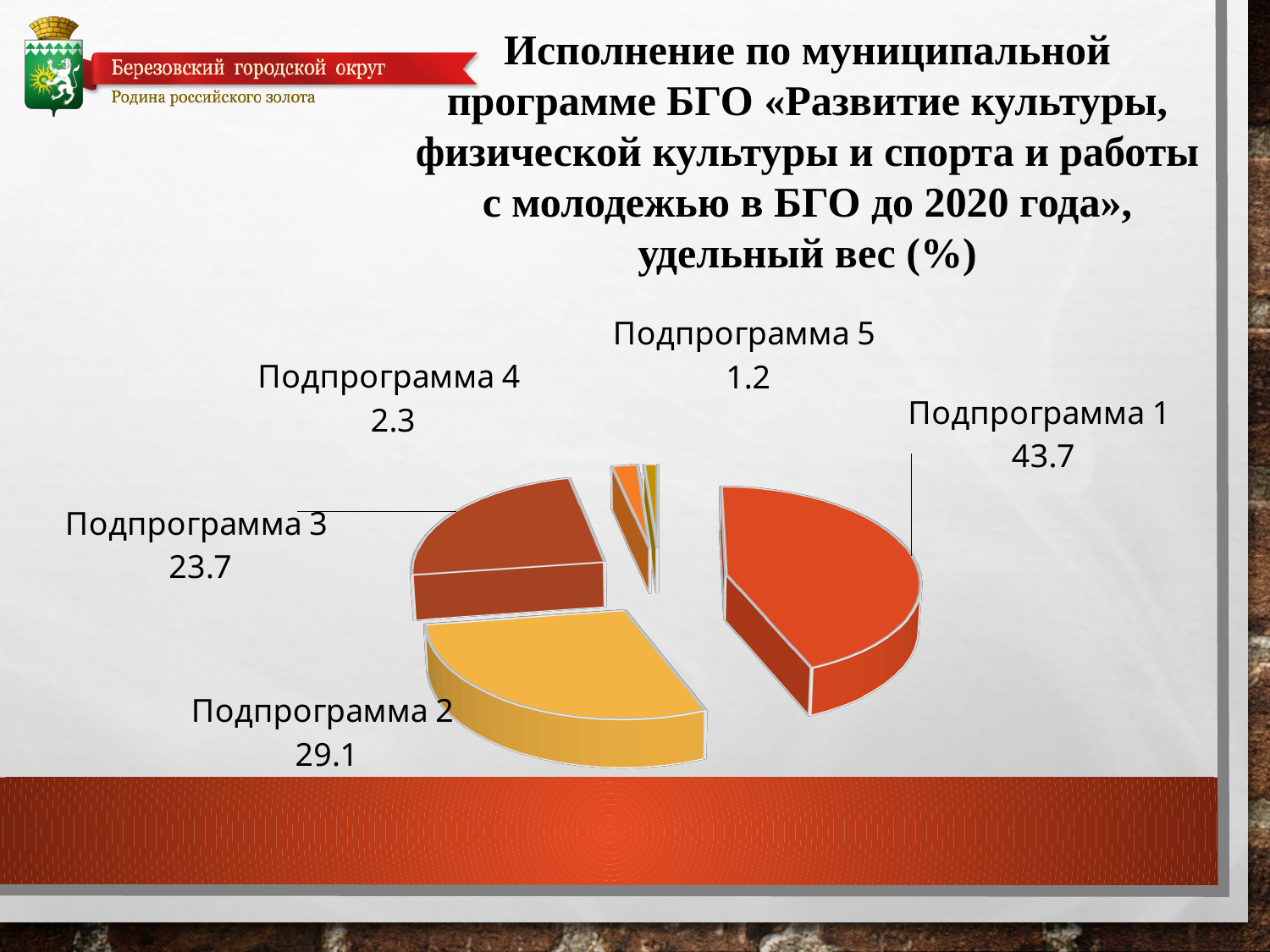
What is the difference between the values for Подпрограмма 4 and Подпрограмма 5? 1.1 What is the difference between the values for Подпрограмма 1 and Подпрограмма 2? 14.6 How many slices does the pie chart have? 5 What is the combined value of Подпрограмма 2 and Подпрограмма 3? 52.8 Which subprogram has the largest share of the pie? Подпрограмма 1 What unit does the chart title say the values are expressed in? % What is the value shown for Подпрограмма 5? 1.2 Which is larger, the value for Подпрограмма 2 or Подпрограмма 3? Подпрограмма 2 What is the value shown for Подпрограмма 1? 43.7 What is the value shown for Подпрограмма 3? 23.7 Which subprogram has the smallest share of the pie? Подпрограмма 5 What kind of chart is shown on the slide? pie chart